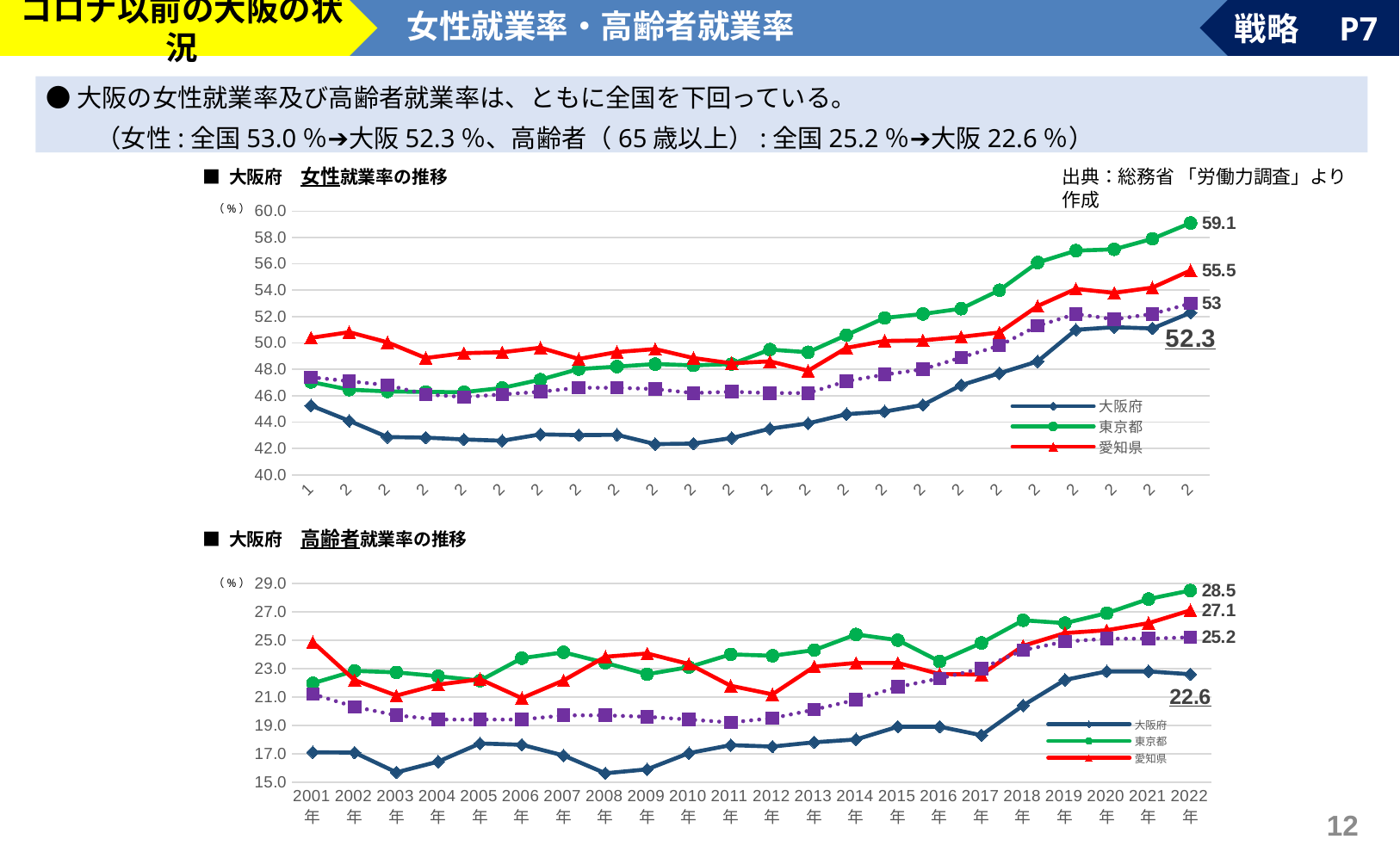
In the top chart (女性就業率の推移), what is the difference between the final labelled values for 東京都 and 大阪府? 6.8 How many series does the legend of the bottom chart (高齢者就業率の推移) list? 3 In the bottom chart (高齢者就業率の推移), is the value for 大阪府 in 2008年 greater or less than 17.0? less In the bottom chart (高齢者就業率の推移), does the 東京都 line generally rise or fall from 2001年 to 2022年? rise In the top chart (女性就業率の推移), which legend series has the highest value at the right end of the chart? 東京都 In the bottom chart (高齢者就業率の推移), which legend series has the lowest value at the right end of the chart? 大阪府 In the top chart (女性就業率の推移), what is the labelled value for 愛知県 at the right end of the line? 55.5 In the bottom chart (高齢者就業率の推移), what is the labelled value for 東京都 at the right end of the line? 28.5 In the top chart (女性就業率の推移), what is the labelled value for 大阪府 at the right end of the line? 52.3 In the top chart (女性就業率の推移), what is the labelled value for 東京都 at the right end of the line? 59.1 In the bottom chart (高齢者就業率の推移), what is the labelled value for 大阪府 at the right end of the line? 22.6 What type of chart is the top chart titled 大阪府 女性就業率の推移? line chart